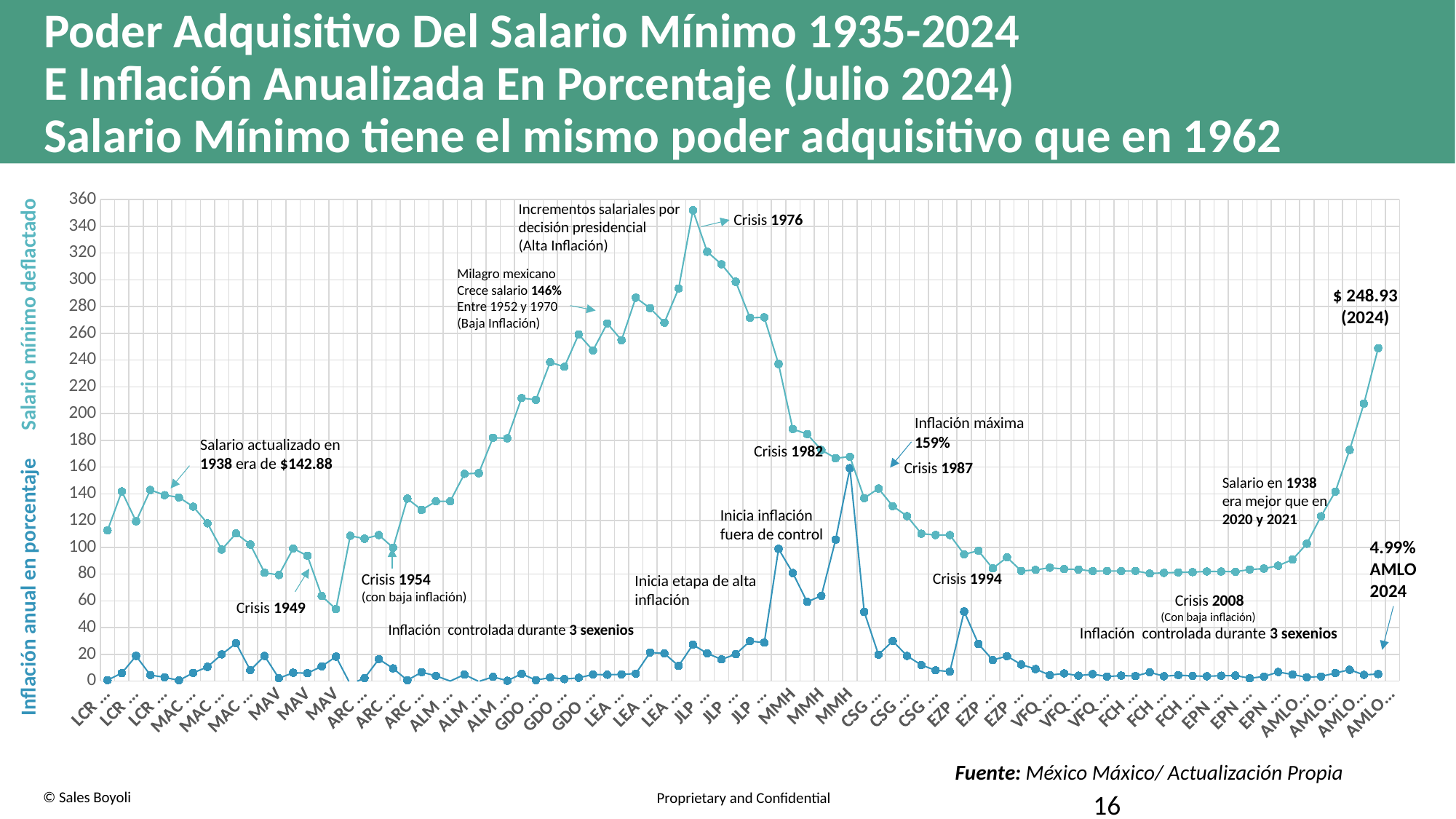
What is the difference between the deflated minimum wage in 2024 ($248.93) and in 1938 ($142.88)? $106.05 What is the deflated minimum wage value shown for 2024? $ 248.93 What kind of chart is shown on the slide? line chart Is the peak value of the deflated minimum wage (Crisis 1976) greater or less than 340? greater Is the deflated minimum wage during the VFQ and FCH periods greater or less than 100? less What is the maximum inflation value annotated on the chart (Crisis 1987)? 159% How many data series are plotted on the chart? 2 What annual inflation percentage is shown for AMLO 2024? 4.99% Does the deflated minimum wage rise or fall from the 1976 peak through the 1990s? fall According to the annotation, what was the updated minimum wage in 1938? $142.88 In which year does the deflated minimum wage line reach its highest point? 1976 Which is larger, the deflated minimum wage in 2024 or in 1938? 2024